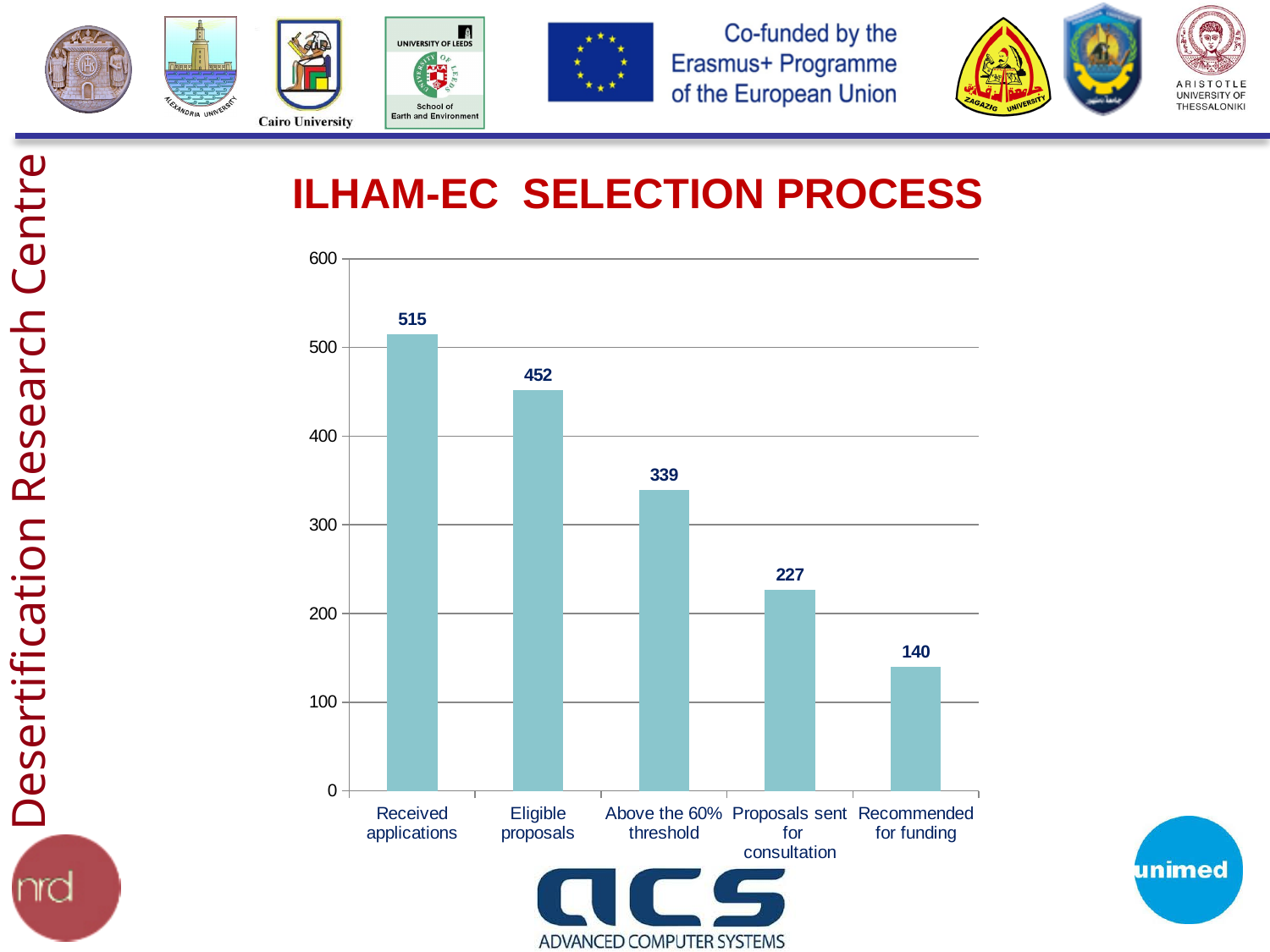
What is the value for Eligible proposals? 452 What is the difference between Proposals sent for consultation and Recommended for funding? 87 Which is larger, Above the 60% threshold or Proposals sent for consultation? Above the 60% threshold What is the value for Received applications? 515 Which category has the lowest value? Recommended for funding What is the difference between Received applications and Eligible proposals? 63 Which category has the highest value? Received applications What kind of chart is shown on the slide? Bar chart How many categories are shown in the chart? 5 What is the value for Recommended for funding? 140 What is the value for Proposals sent for consultation? 227 What is the value for Above the 60% threshold? 339